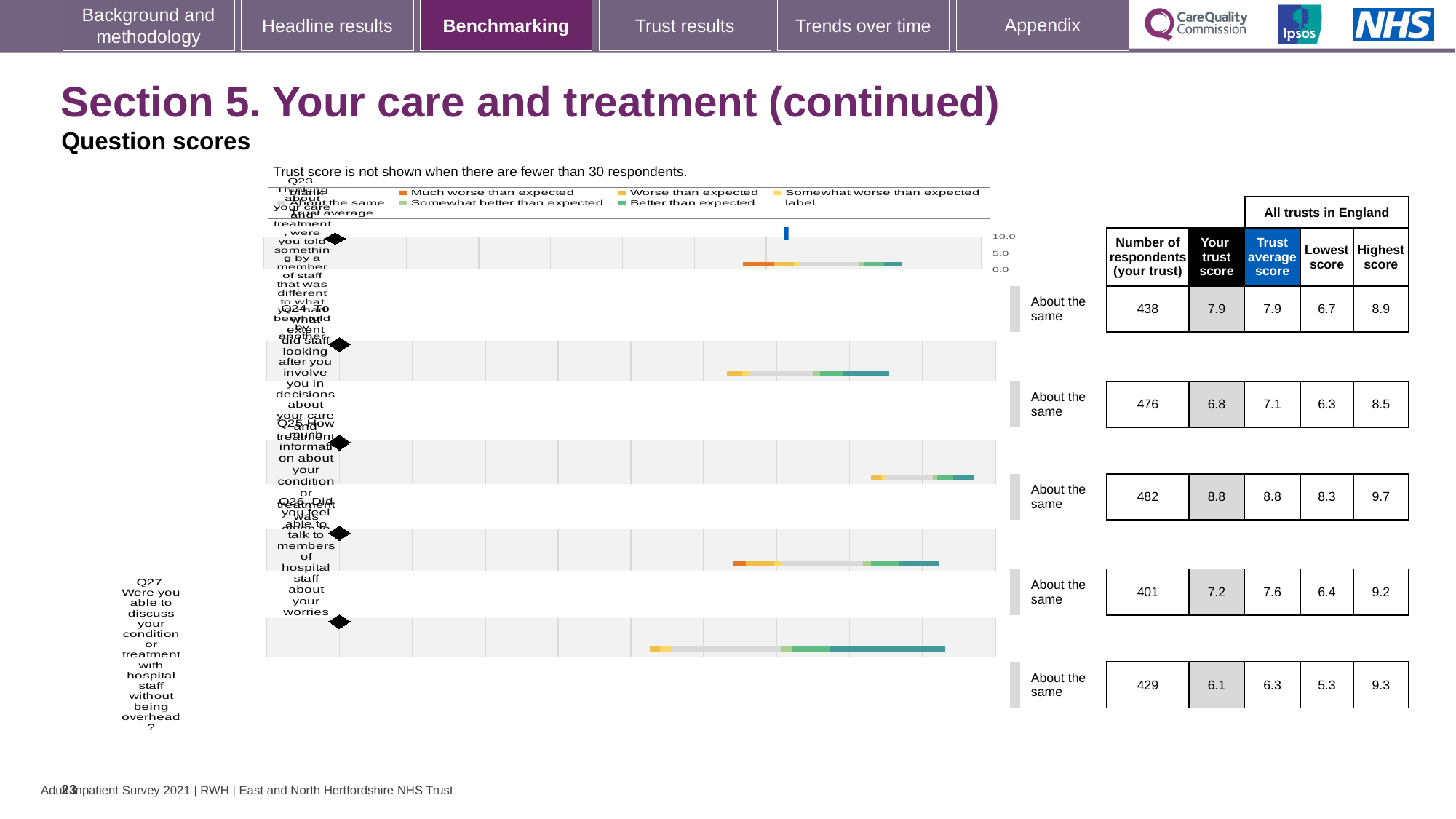
What is the trust score for Q25 (How much information about your condition or treatment was given to you)? 8.8 What benchmark category is shown for every question on this slide? About the same What is the maximum value shown on the chart's score axis? 10.0 How many respondents answered Q23 at this trust? 438 How many questions (Q23 to Q27) are plotted in the chart? 5 Which question has the highest trust score? Q25 Which question has the lowest trust score? Q27 For Q24, which is larger: the trust score or the trust average score? Trust average score What type of chart is used to show the question scores on this slide? bar chart What is the difference between the trust average score and the trust score for Q26? 0.4 What is the highest score across all trusts in England for Q27? 9.3 What is the trust score for Q27 (Were you able to discuss your condition or treatment with hospital staff without being overheard)? 6.1